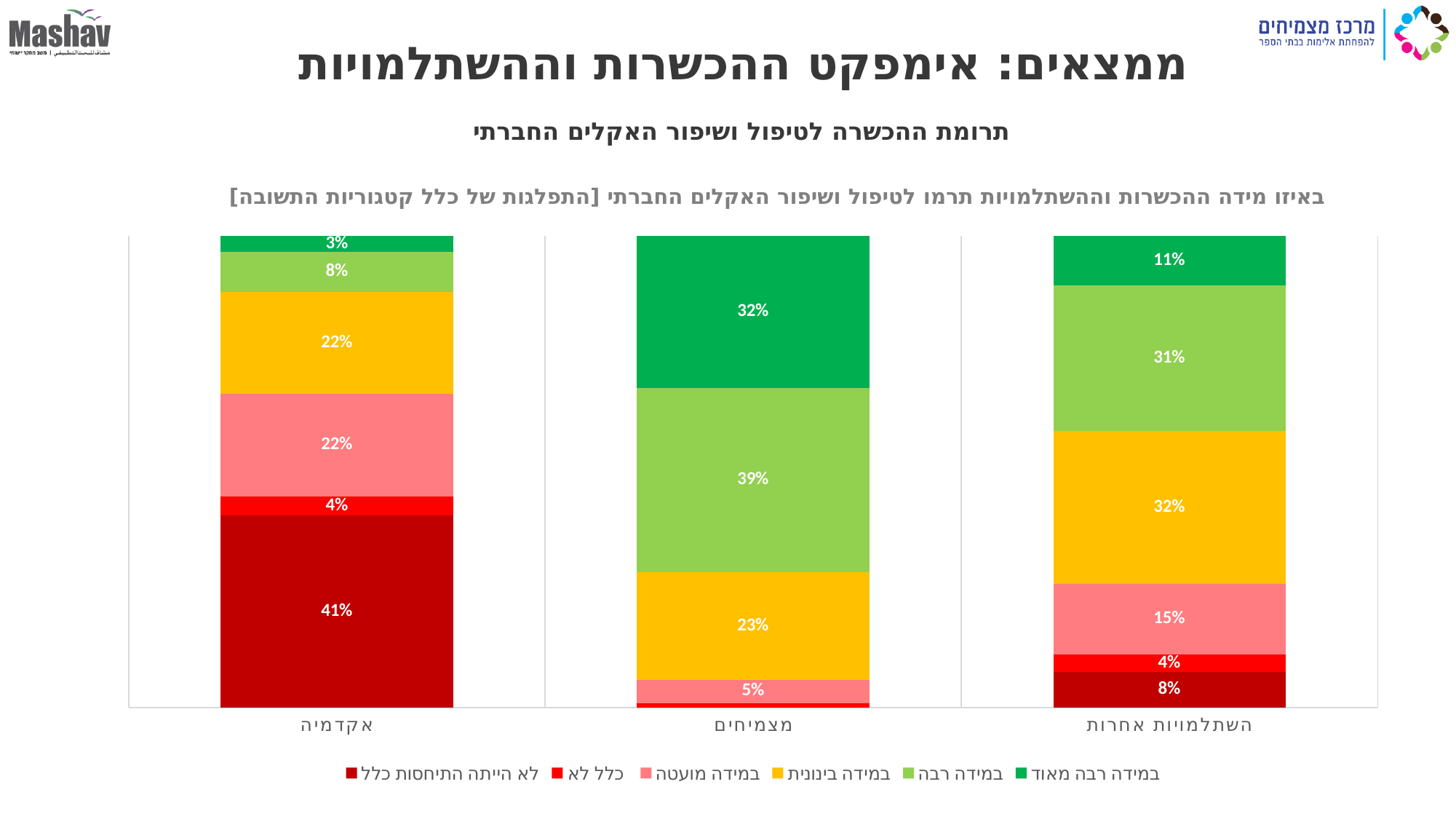
Which category has the lowest value for the 'במידה רבה' series? אקדמיה Which category has the highest value for the 'במידה רבה מאוד' series? מצמיחים What is the value of the 'במידה רבה' segment for 'מצמיחים'? 39% What is the value of the 'לא הייתה התיחסות כלל' segment for 'אקדמיה'? 41% Which colour represents the 'במידה בינונית' series in the legend? yellow How many categories are shown along the x axis of the chart? 3 Which is larger: the 'במידה מועטה' value for 'אקדמיה' or for 'השתלמויות אחרות'? אקדמיה What is the value of the 'במידה רבה מאוד' segment for 'אקדמיה'? 3% How many series does the chart's legend list? 6 What is the value of the 'במידה בינונית' segment for 'השתלמויות אחרות'? 32% What kind of chart is shown on the slide? stacked bar chart What is the difference between the 'במידה רבה מאוד' values for 'מצמיחים' and 'השתלמויות אחרות'? 21%